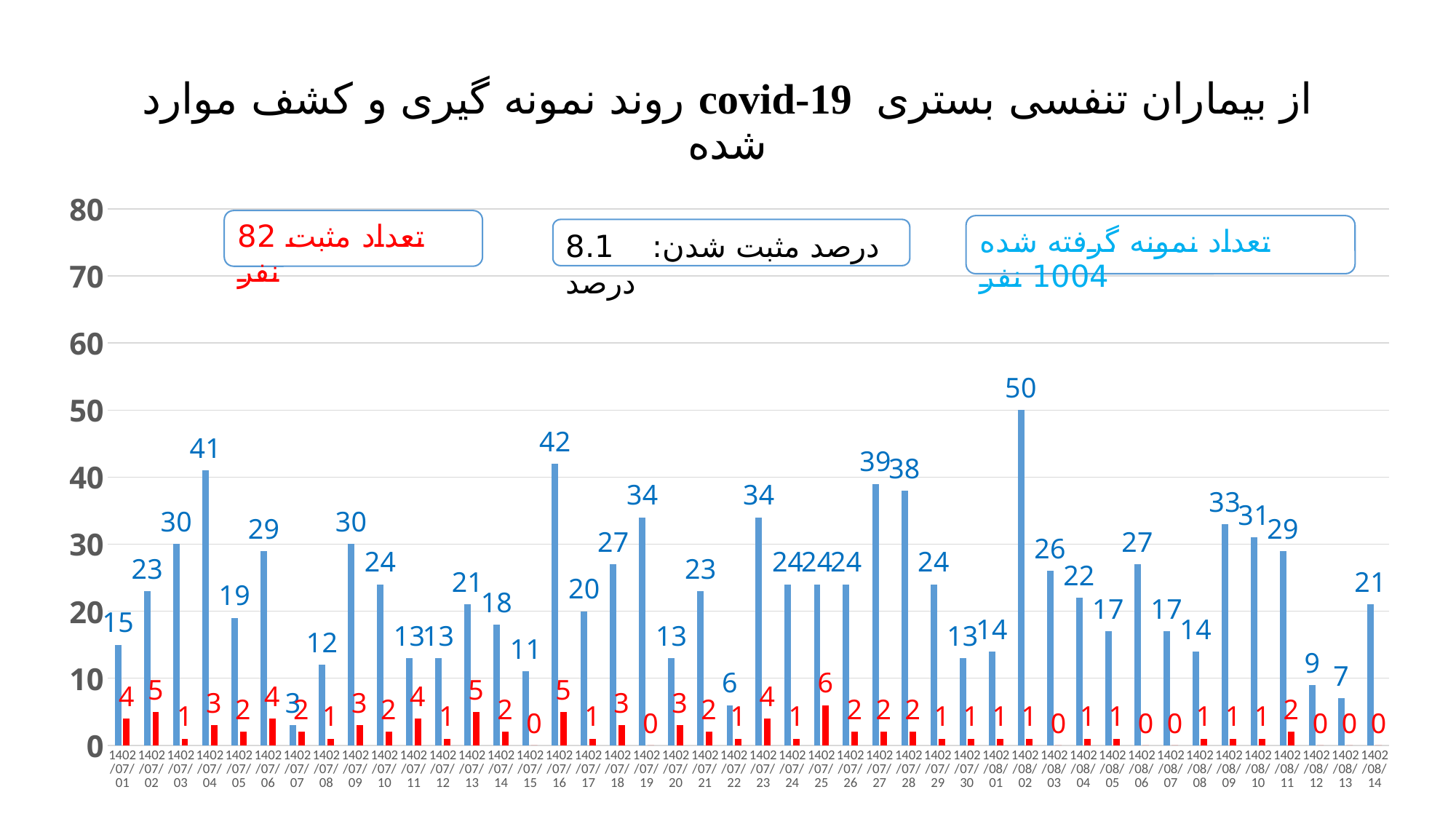
What is the difference between the blue bar values for 1402/07/16 and 1402/07/15? 31 According to the text box on the slide, what is the total number of samples taken (تعداد نمونه گرفته شده)? 1004 What is the value of the blue bar for 1402/08/02? 50 What is the value of the blue bar for 1402/07/01? 15 Which date has the lowest blue bar? 1402/07/07 Which has a larger blue bar value, 1402/07/04 or 1402/07/27? 1402/07/04 Which date has the highest blue bar? 1402/08/02 What is the value of the red bar for 1402/07/25? 6 How many dates are shown on the x axis? 44 Is the blue bar value for 1402/07/16 greater or less than 40? greater What is the value of the red bar for 1402/08/14? 0 What kind of chart is shown on the slide? bar chart